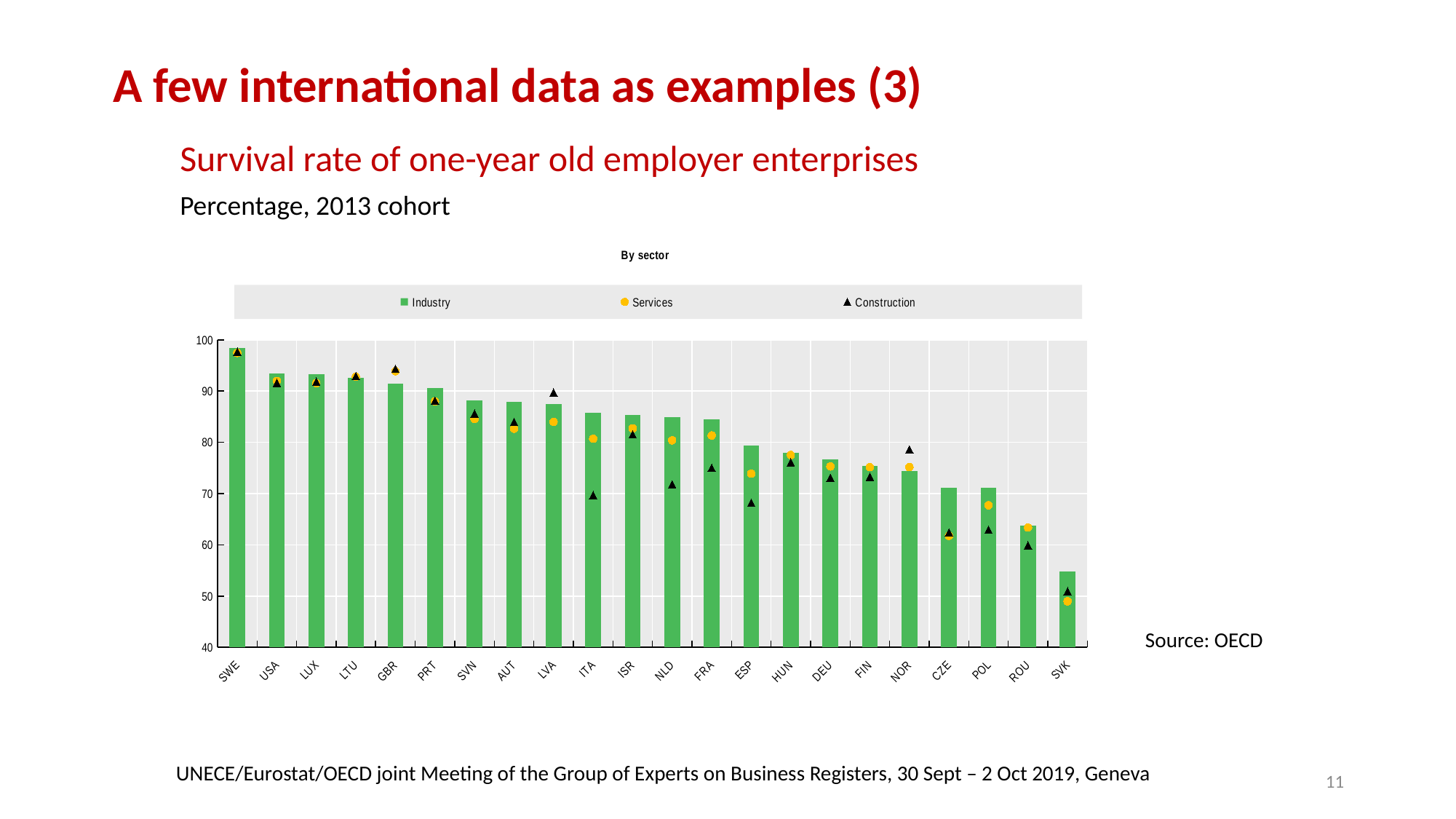
How many countries are shown along the x axis of the chart? 22 How many series does the chart's legend list? 3 Which country has the highest Industry survival rate bar? SWE Which is larger, the Industry bar for USA or the Industry bar for POL? USA What kind of chart is shown on the slide? bar chart Is the Industry bar for SVK greater or less than 60? less Is the Industry bar for GBR greater or less than 90? greater Is the Construction value for ITA greater or less than 80? less Do the Industry bars rise or fall from left to right along the x axis? fall What is the title of the chart shown on the slide? By sector Which country has the lowest Industry survival rate bar? SVK Which series in the legend is represented by a triangle marker? Construction